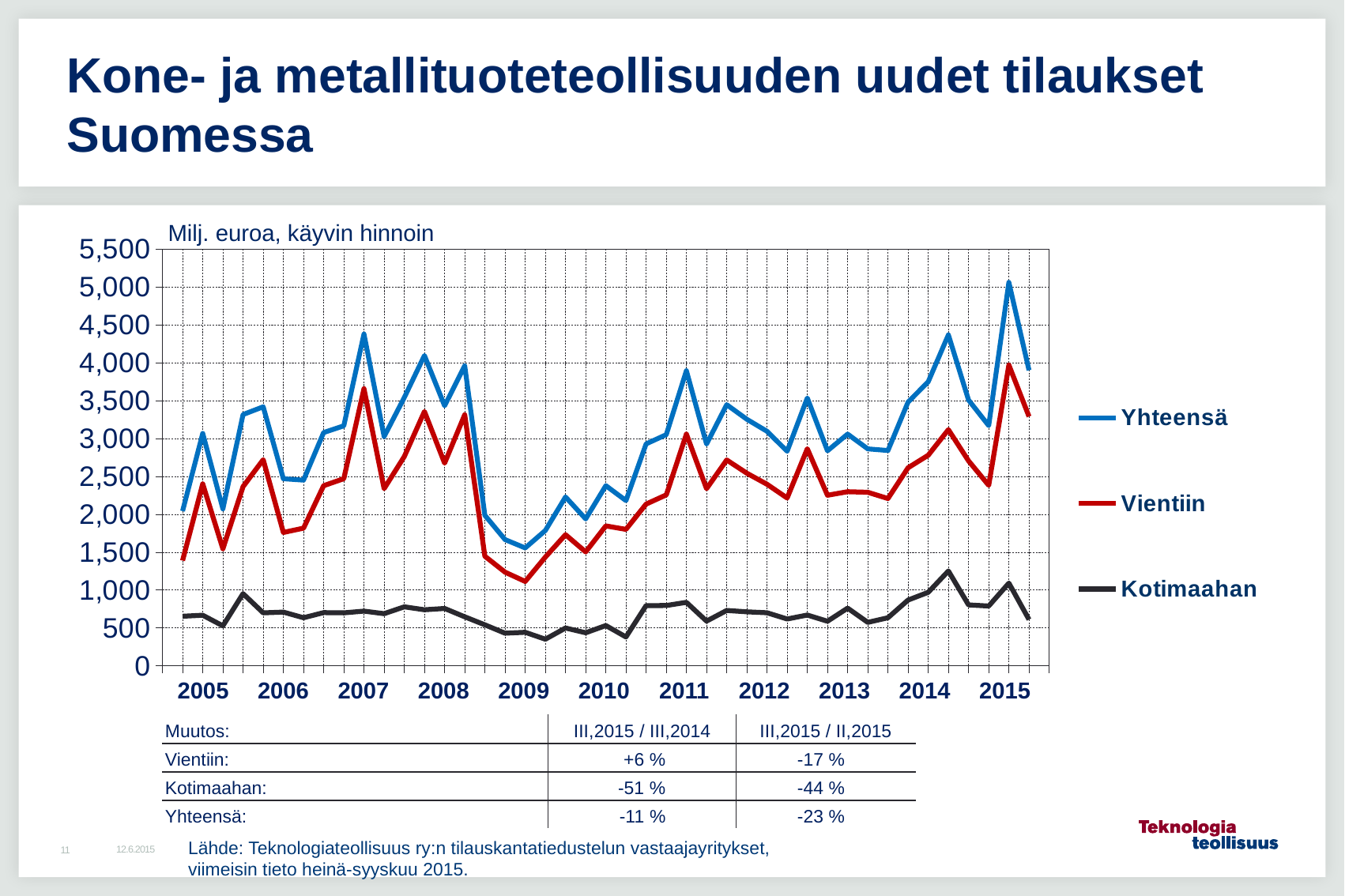
In which year does the Kotimaahan series reach its highest point? 2014 Is the highest value of the Kotimaahan series greater or less than 1,000? greater Which series are listed in the legend? Yhteensä, Vientiin, Kotimaahan What unit is stated above the chart? Milj. euroa, käyvin hinnoin In which year does the Yhteensä series reach its highest point? 2015 Is the peak of the Yhteensä series in 2007 greater or less than 4,000? greater Is the lowest value of the Vientiin series in 2009 greater or less than 1,500? less What kind of chart is shown on the slide? line chart How many series does the legend list? 3 How many years are labelled on the x axis? 11 In which year does the Vientiin series reach its lowest point? 2009 Which series has the lowest values throughout the period, Vientiin or Kotimaahan? Kotimaahan